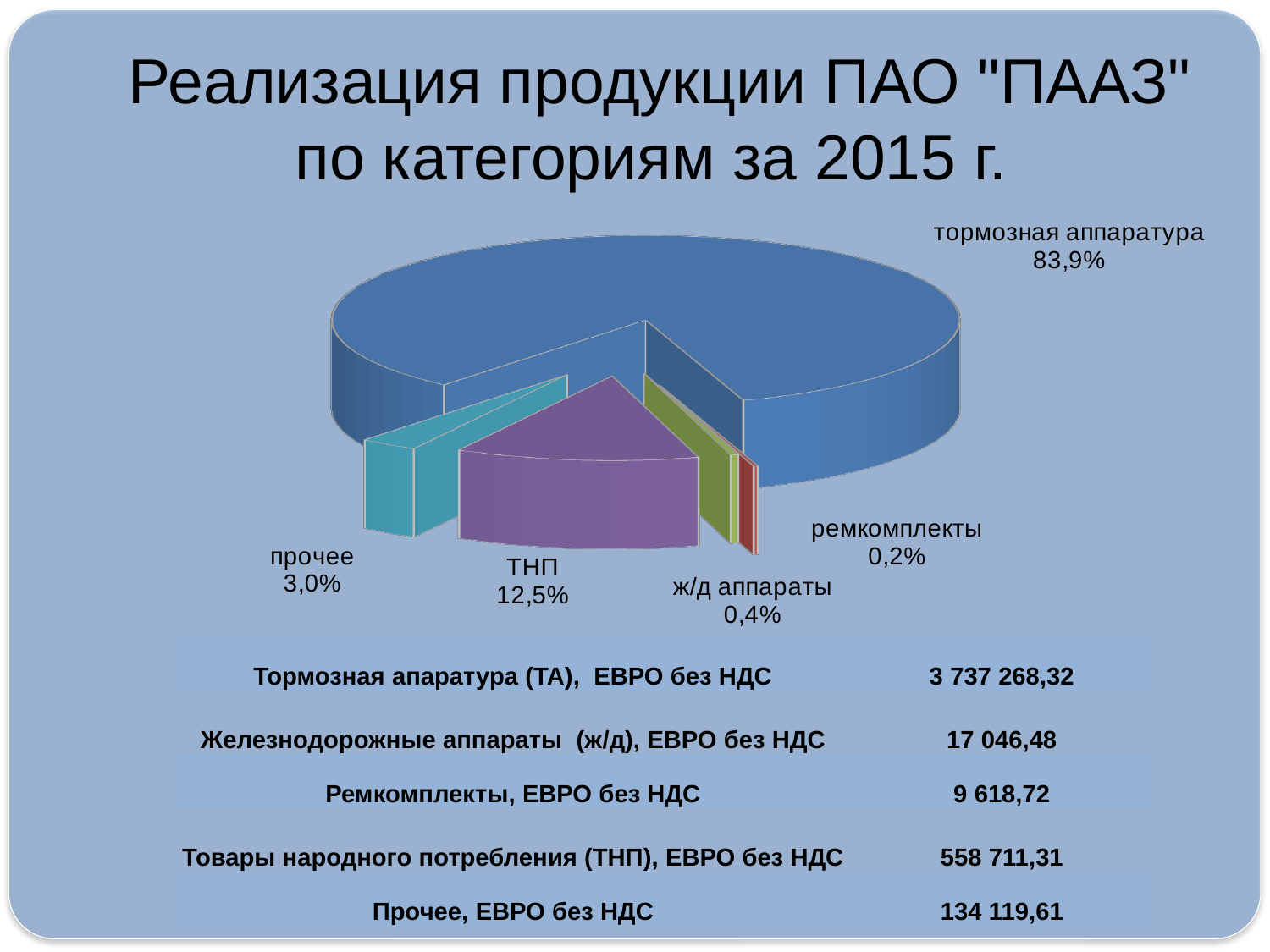
Which slice is larger, ТНП or прочее? ТНП What share of the pie does ТНП have? 12,5% How many slices does the pie chart have? 5 What is the difference in percentage points between the ТНП slice and the прочее slice? 9,5 What share of the pie does тормозная аппаратура have? 83,9% What share of the pie does ремкомплекты have? 0,2% Which category has the smallest slice of the pie? ремкомплекты What is the title of the slide containing the pie chart? Реализация продукции ПАО "ПААЗ" по категориям за 2015 г. Which category has the largest slice of the pie? тормозная аппаратура What kind of chart is shown on the slide? Pie chart